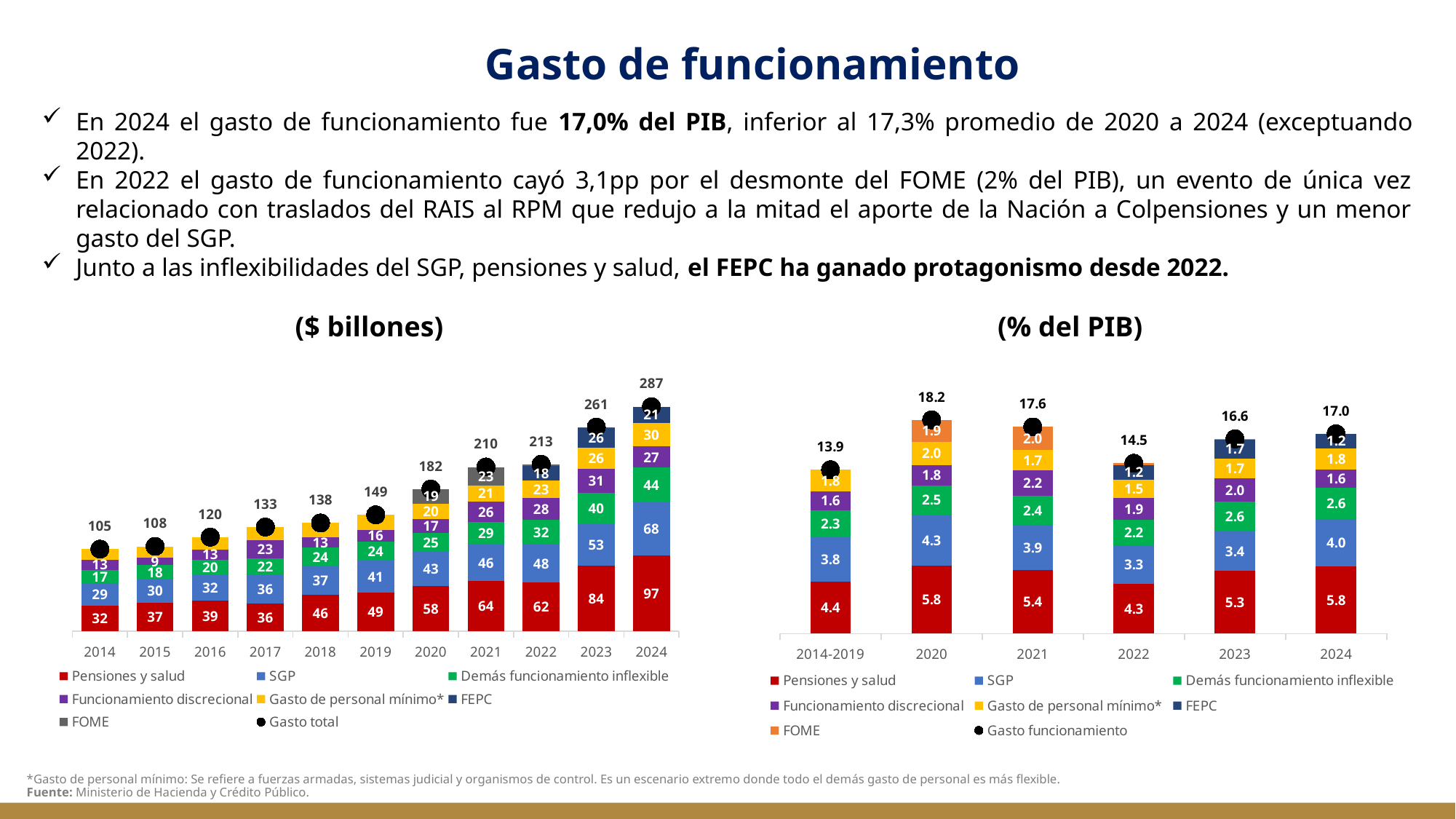
In the "(% del PIB)" chart, what is the difference between the FEPC values for 2023 and 2024? 0.5 In the "($ billones)" chart, how many years are shown on the x axis? 11 In the "(% del PIB)" chart, which period has the lowest Gasto funcionamiento? 2014-2019 In the "($ billones)" chart, what is the difference between the Gasto total for 2023 and 2022? 48 In the "(% del PIB)" chart, what is the Gasto funcionamiento value for 2022? 14.5 What kind of chart is the "($ billones)" chart? Stacked bar chart How many entries does the legend of the "(% del PIB)" chart list? 8 In the "(% del PIB)" chart, is the Pensiones y salud value larger in 2021 or in 2023? 2021 In the "(% del PIB)" chart, what is the SGP value for 2020? 4.3 In the "($ billones)" chart, which year has the highest Gasto total? 2024 In the "($ billones)" chart, what is the Gasto total value for 2024? 287 In the "($ billones)" chart, what is the Pensiones y salud value for 2019? 49